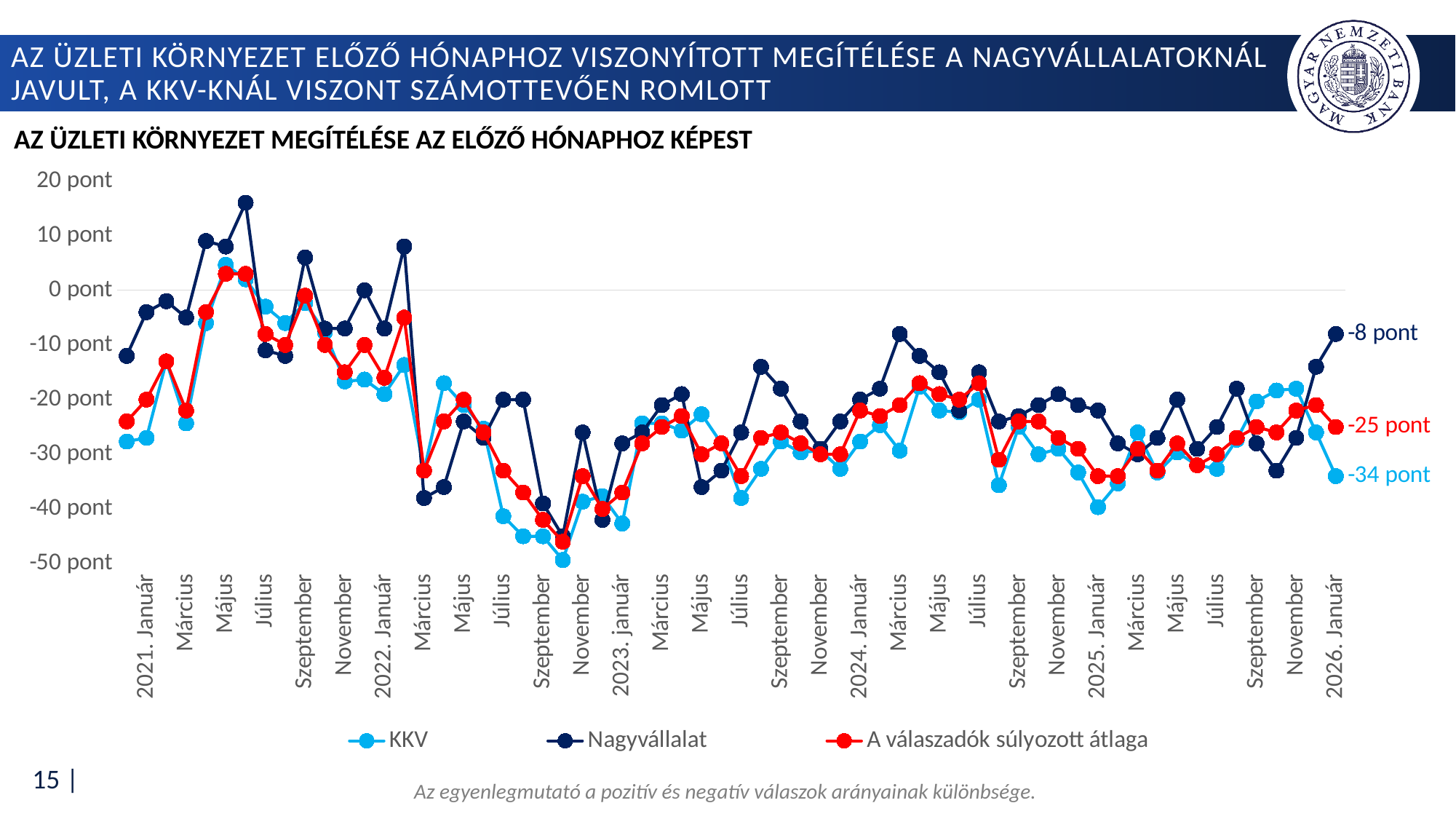
What is the value for A válaszadók súlyozott átlaga in 2026. Január? -25 pont Which is higher in 2026. Január, KKV or Nagyvállalat? Nagyvállalat What is the difference between the Nagyvállalat and KKV values in 2026. Január? 26 pont Is the value for KKV in 2022. Szeptember greater or less than -40 pont? less What kind of chart is shown on the slide? line chart What is the value for Nagyvállalat in 2026. Január? -8 pont Is the value for Nagyvállalat in 2021. Május greater or less than 0 pont? greater How many series does the legend list? 3 What is the value for KKV in 2026. Január? -34 pont What is the difference between A válaszadók súlyozott átlaga and KKV in 2026. Január? 9 pont Which series has the lowest value in 2026. Január? KKV Does the KKV line rise or fall from 2025. November to 2026. Január? falls